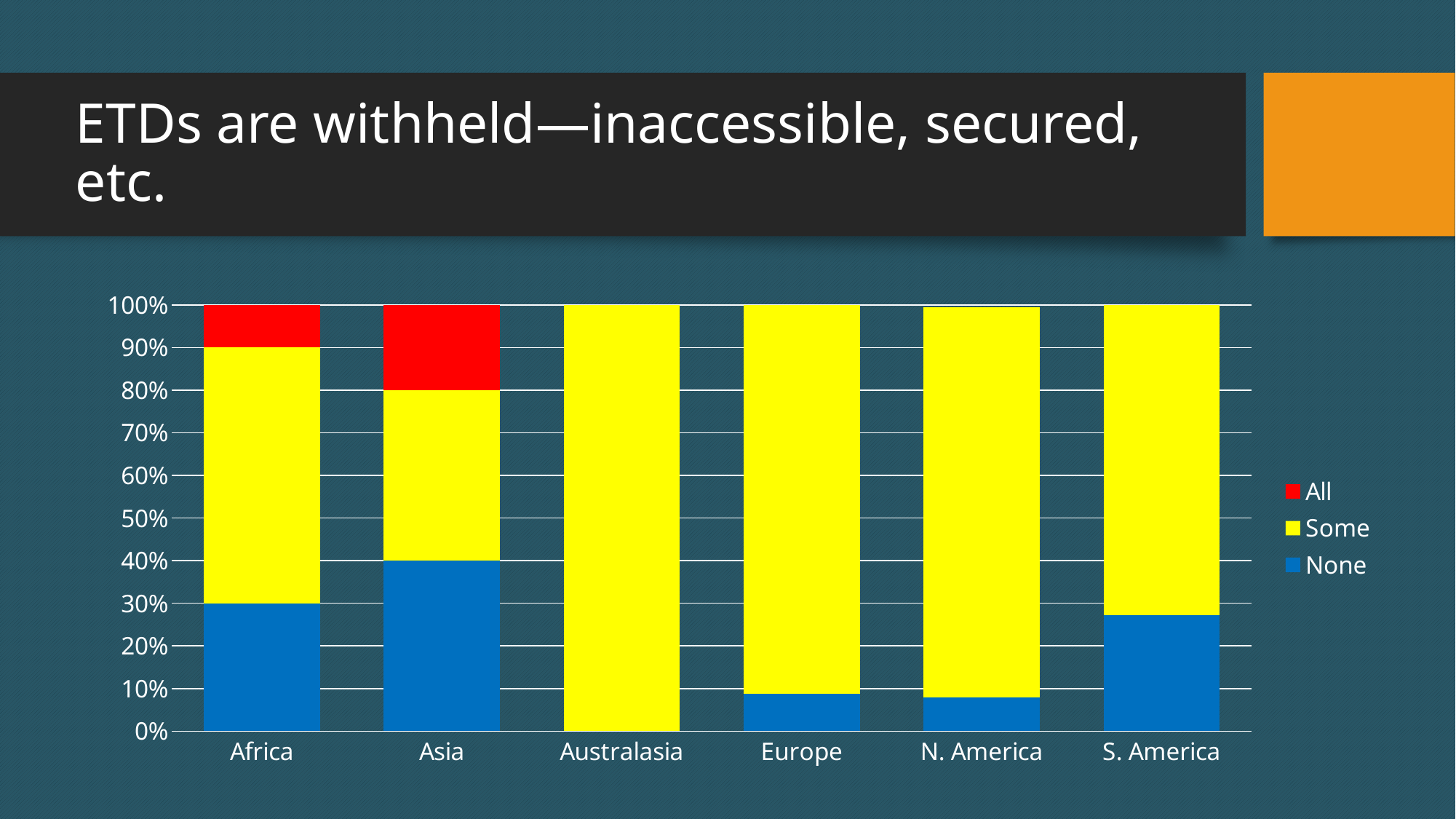
Which region's bar consists entirely of the Some series? Australasia Which region has the largest None (blue) segment? Asia Which region has the largest All (red) segment? Asia Which series is shown in red in the chart? All What is the value of the None series for Africa? 30% What kind of chart is shown on the slide? stacked bar chart Is the None value for Europe greater or less than 10%? less Is the None value for S. America greater or less than 20%? greater How many regions are shown on the x axis of the chart? 6 Which is larger, the None value for Africa or the None value for N. America? Africa What is the value of the None series for Asia? 40% How many series does the chart legend list? 3